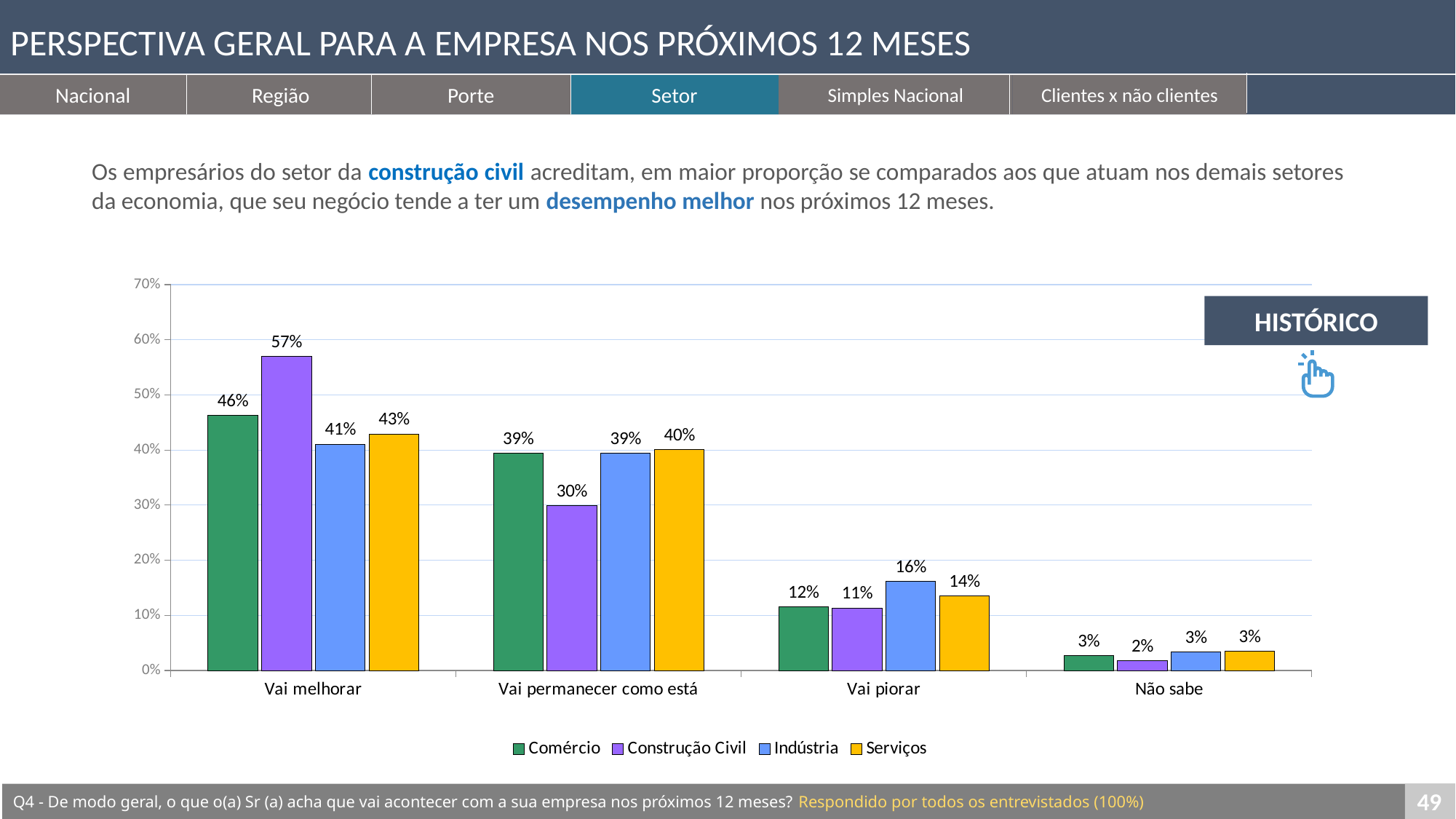
What is the difference between the Construção Civil and Comércio values in the 'Vai melhorar' category? 11% What is the value for Indústria in the 'Vai piorar' category? 16% What kind of chart is shown on the slide? Bar chart How many categories are shown on the x axis? 4 In the 'Vai piorar' category, which is larger: the value for Indústria or the value for Serviços? Indústria Which series has the lowest value in the 'Vai permanecer como está' category? Construção Civil Which series has the highest value in the 'Vai melhorar' category? Construção Civil How many series does the legend list? 4 What is the value for Construção Civil in the 'Vai melhorar' category? 57% Is the value for Construção Civil in 'Vai melhorar' greater or less than 50%? greater What is the value for Serviços in the 'Vai permanecer como está' category? 40% What colour represents the Serviços series in the chart? Yellow